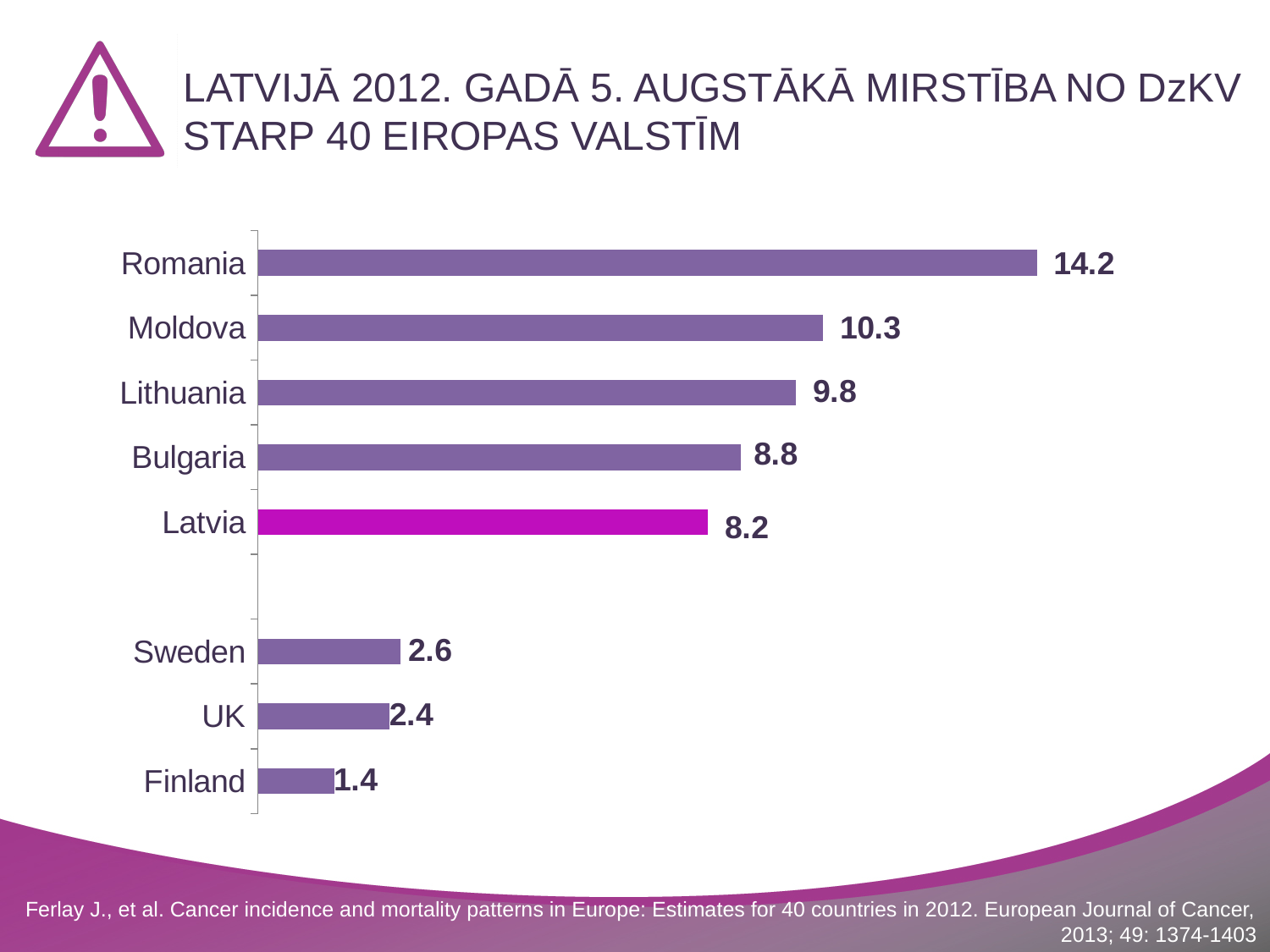
Which country has the highest value? Romania Which is larger, the value for Sweden or the value for UK? Sweden What is the difference between the values for Latvia and Sweden? 5.6 What is the difference between the values for Romania and Moldova? 3.9 What is the value for Latvia? 8.2 How many countries are shown in the chart? 8 What kind of chart is shown on the slide? bar chart Which country has the lowest value? Finland Which country's bar is highlighted in a different colour (magenta) from the others? Latvia What is the value for Romania? 14.2 Which is larger, the value for Lithuania or the value for Bulgaria? Lithuania What is the value for Finland? 1.4